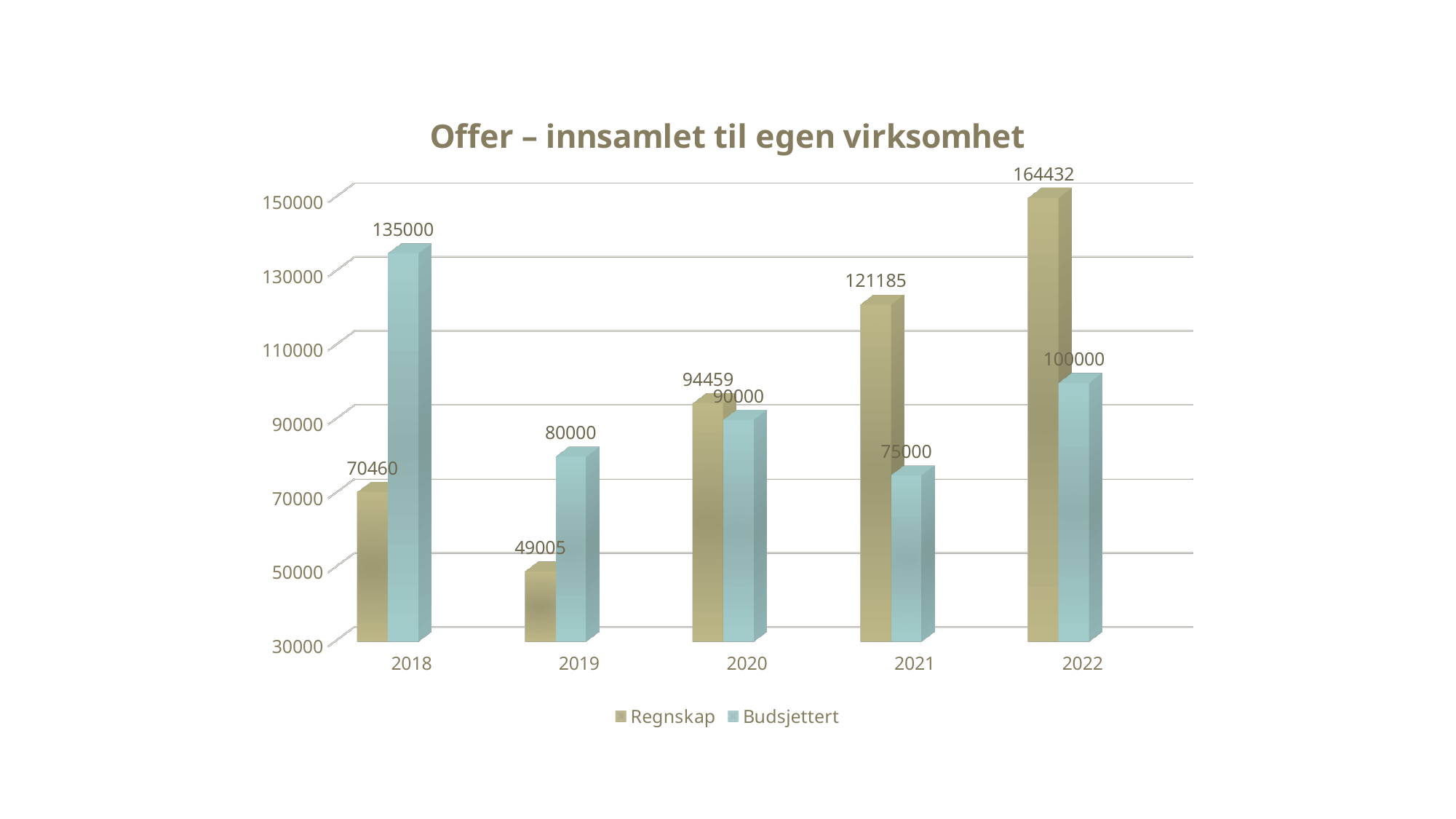
What is the Regnskap value for 2022? 164432 How many series does the legend list? 2 What is the title of the chart? Offer – innsamlet til egen virksomhet What is the difference between the Regnskap values for 2022 and 2021? 43247 Which year has the lowest Budsjettert value? 2021 What is the difference between the Budsjettert and Regnskap values for 2018? 64540 What kind of chart is shown? Bar chart What is the Regnskap value for 2019? 49005 Which year has the highest Regnskap value? 2022 What is the Budsjettert value for 2018? 135000 How many years are shown on the x axis? 5 Which is larger in 2021, Regnskap or Budsjettert? Regnskap